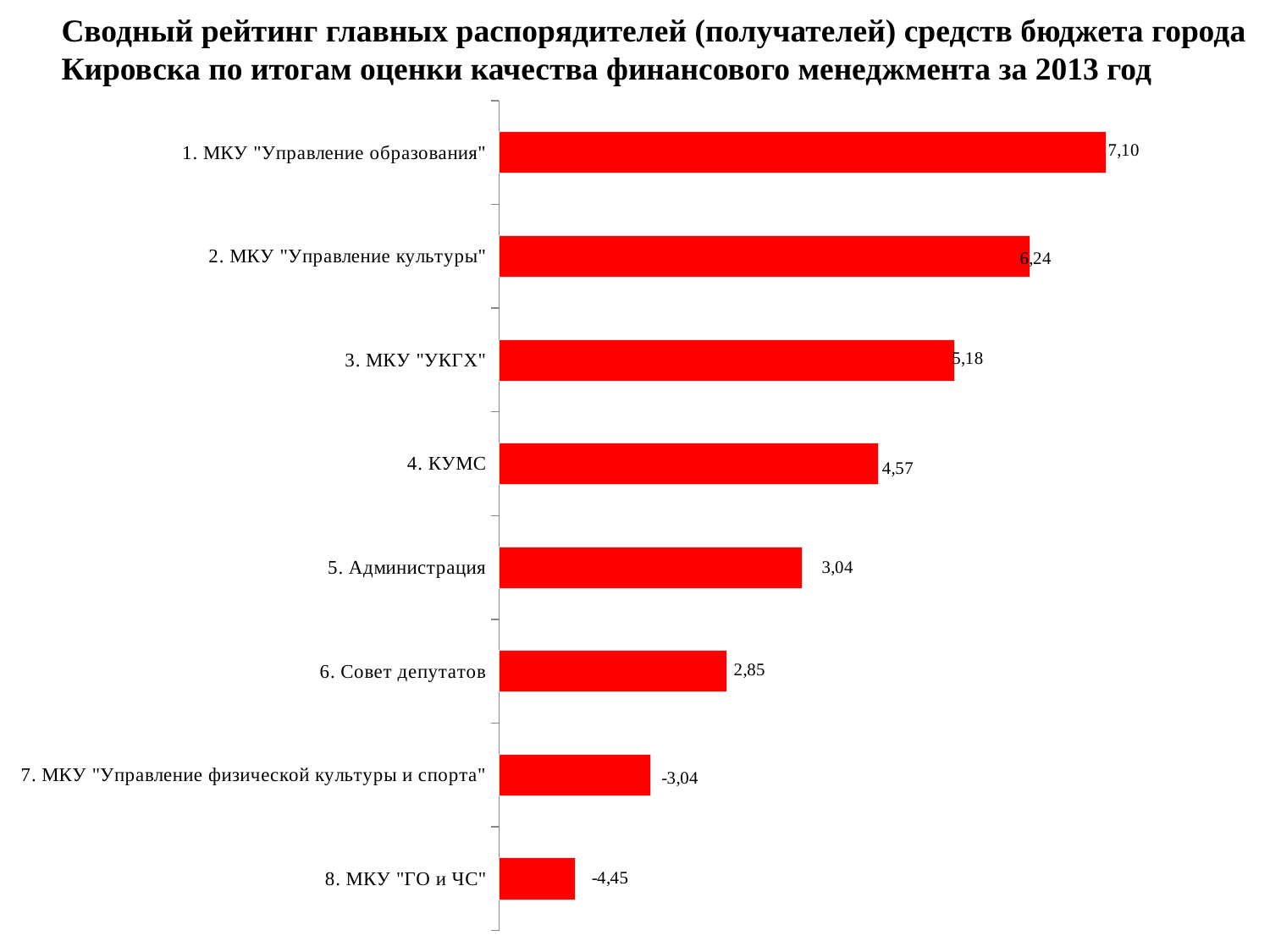
What value is labelled for 8. МКУ "ГО и ЧС"? -4,45 What value is shown for 4. КУМС? 4,57 Which category has the lowest value? 8. МКУ "ГО и ЧС" What is the difference between the values for 1. МКУ "Управление образования" and 2. МКУ "Управление культуры"? 0,86 What is the difference between the values for 3. МКУ "УКГХ" and 4. КУМС? 0,61 Which has the larger value, 5. Администрация or 6. Совет депутатов? 5. Администрация What value is shown for 1. МКУ "Управление образования"? 7,10 How many categories are shown in the chart? 8 What colour are the bars in the chart? Red What kind of chart is shown on the slide? Bar chart What value is shown for 6. Совет депутатов? 2,85 Which category has the highest value? 1. МКУ "Управление образования"